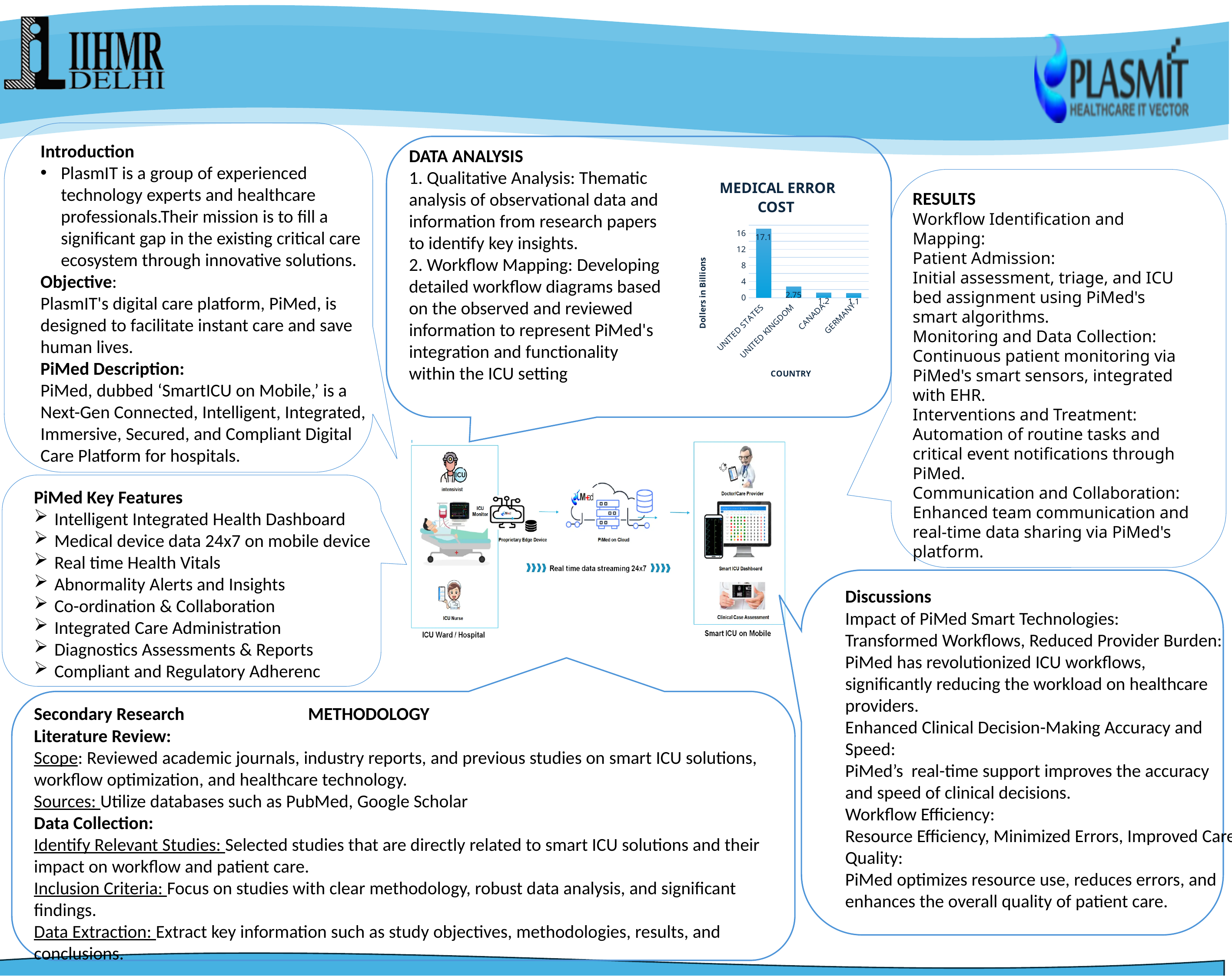
Is the value for the United States greater or less than 16? greater What is the difference between the medical error cost of the United States and the United Kingdom? 14.35 What is the medical error cost for Canada? 1.2 What is the title of the vertical axis of the Medical Error Cost chart? Dollers in Billions How many countries are shown in the Medical Error Cost chart? 4 What is the medical error cost for Germany? 1.1 Which country has the highest medical error cost? United States What is the medical error cost for the United States? 17.1 Do the values rise or fall from left to right across the countries? fall What is the medical error cost for the United Kingdom? 2.75 Which has a larger medical error cost, the United Kingdom or Canada? United Kingdom What kind of chart is the Medical Error Cost chart? bar chart